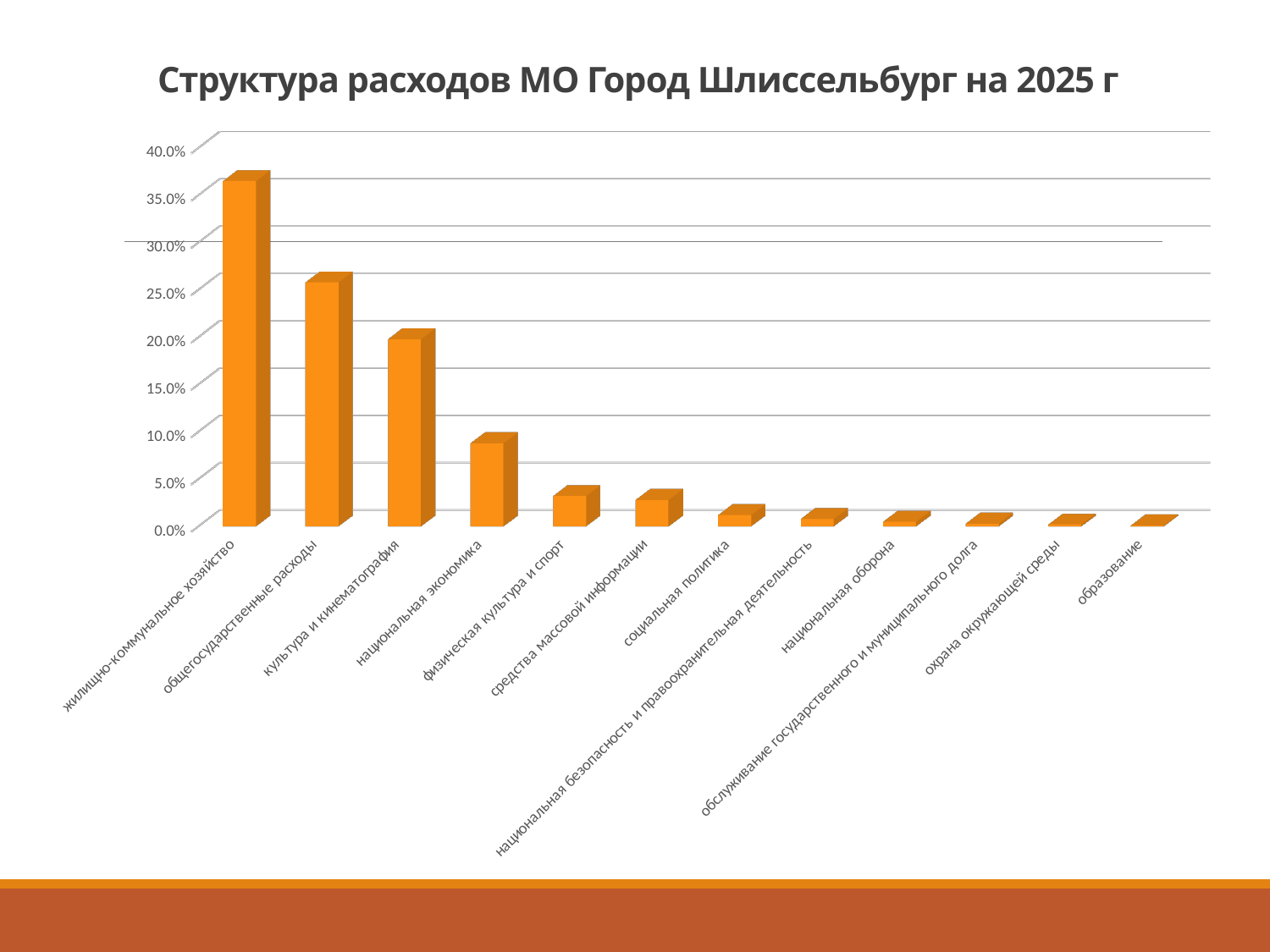
Do the values rise or fall moving from left to right along the x axis? fall What kind of chart is shown on the slide? bar chart Is the value for культура и кинематография greater or less than 25.0%? less How many categories are plotted on the x axis? 12 Is the value for физическая культура и спорт greater or less than 10.0%? less Is the value for общегосударственные расходы greater or less than 20.0%? greater Which category has the highest value? жилищно-коммунальное хозяйство Which is larger, the value for культура и кинематография or the value for национальная экономика? культура и кинематография What is the title of the chart? Структура расходов МО Город Шлиссельбург на 2025 г